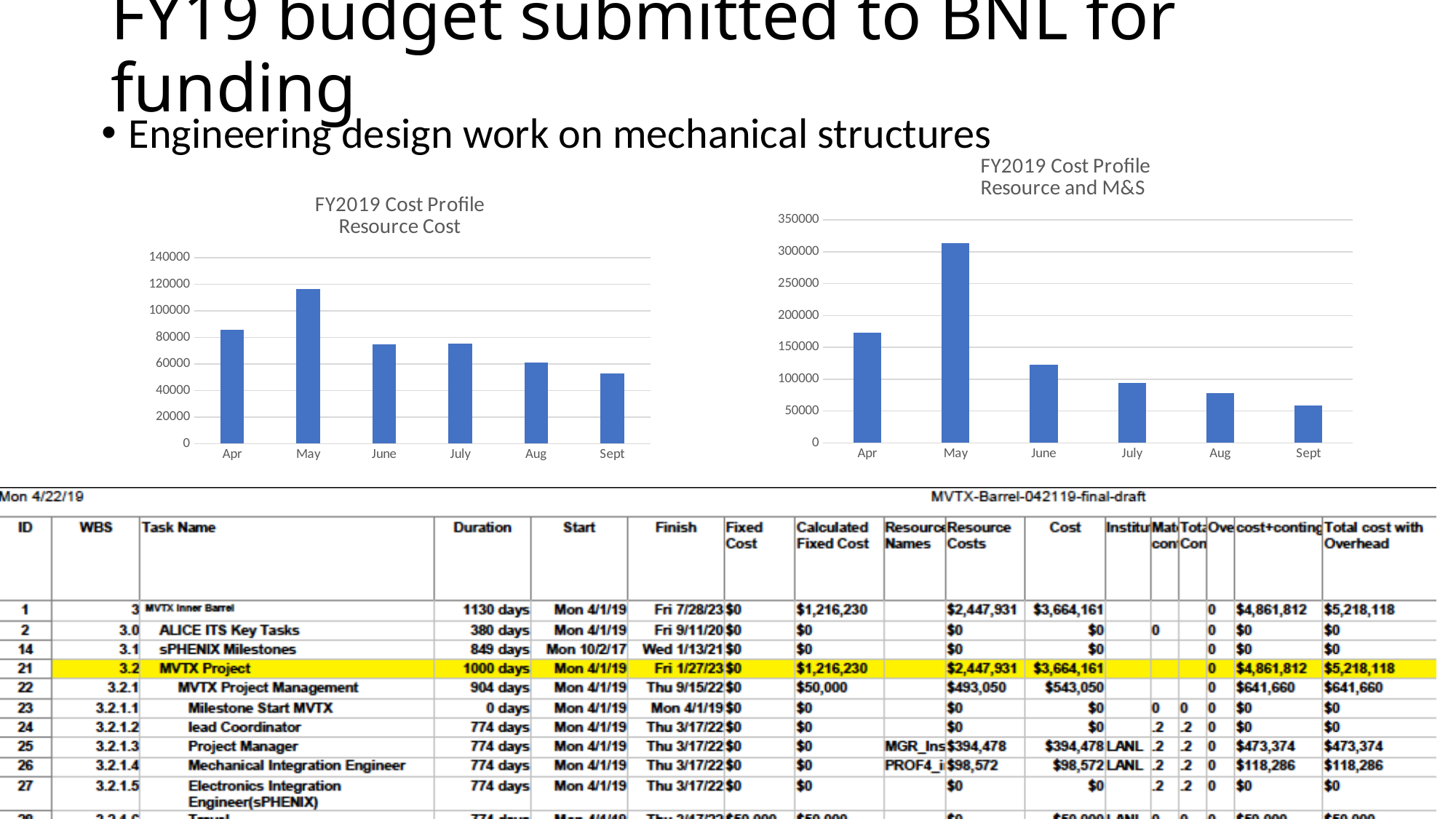
How many months are shown on the x axis of the FY2019 Cost Profile Resource Cost chart? 6 What kind of chart is the FY2019 Cost Profile Resource and M&S chart? Bar chart In the FY2019 Cost Profile Resource and M&S chart, is the value for May greater or less than 300000? greater In the FY2019 Cost Profile Resource Cost chart, is the value for May greater or less than 100000? greater In the FY2019 Cost Profile Resource Cost chart, which month has the highest value? May In the FY2019 Cost Profile Resource Cost chart, is the value for Sept greater or less than 60000? less In the FY2019 Cost Profile Resource Cost chart, which month has the lowest value? Sept In the FY2019 Cost Profile Resource and M&S chart, which month has the highest value? May In the FY2019 Cost Profile Resource Cost chart, which is larger, the value for Apr or the value for Aug? Apr What is the title of the chart on the right side of the slide? FY2019 Cost Profile Resource and M&S In the FY2019 Cost Profile Resource and M&S chart, do the values rise or fall from May to Sept? Fall In the FY2019 Cost Profile Resource and M&S chart, which month has the lowest value? Sept